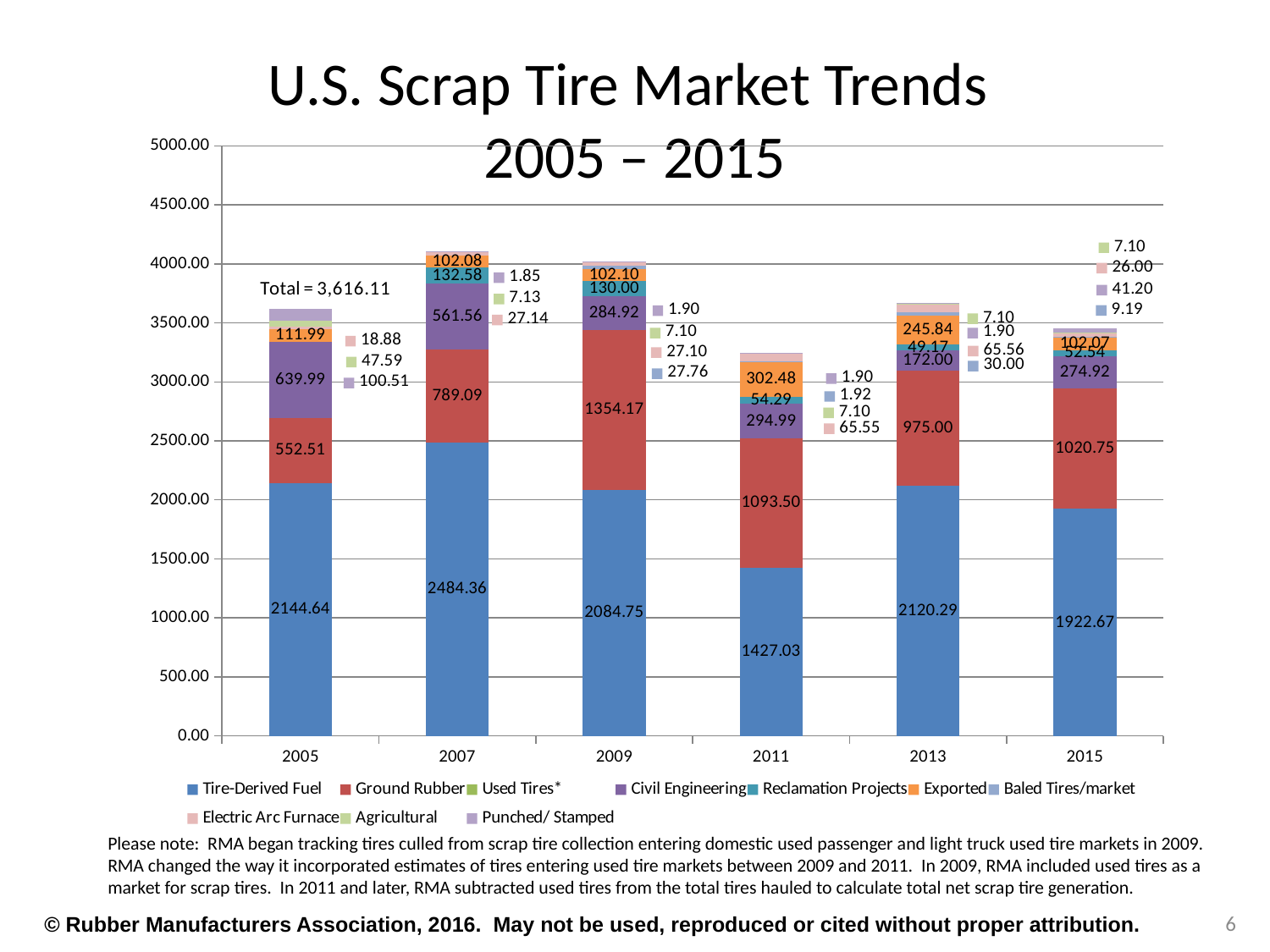
What total is printed above the 2005 bar? 3,616.11 What is the Ground Rubber value for 2015? 1020.75 What kind of chart is shown on the slide? Stacked bar chart How many series does the chart's legend list? 10 How many years are shown on the x axis of the chart? 6 Is the total height of the 2011 stacked bar greater or less than 3500? less Which year has the lowest Civil Engineering value? 2013 Which year has the highest Tire-Derived Fuel value? 2007 What is the Exported value for 2013? 245.84 What is the Tire-Derived Fuel value for 2011? 1427.03 Which is larger, the Ground Rubber value for 2009 or for 2011? 2009 What is the difference between the Tire-Derived Fuel values for 2007 and 2005? 339.72